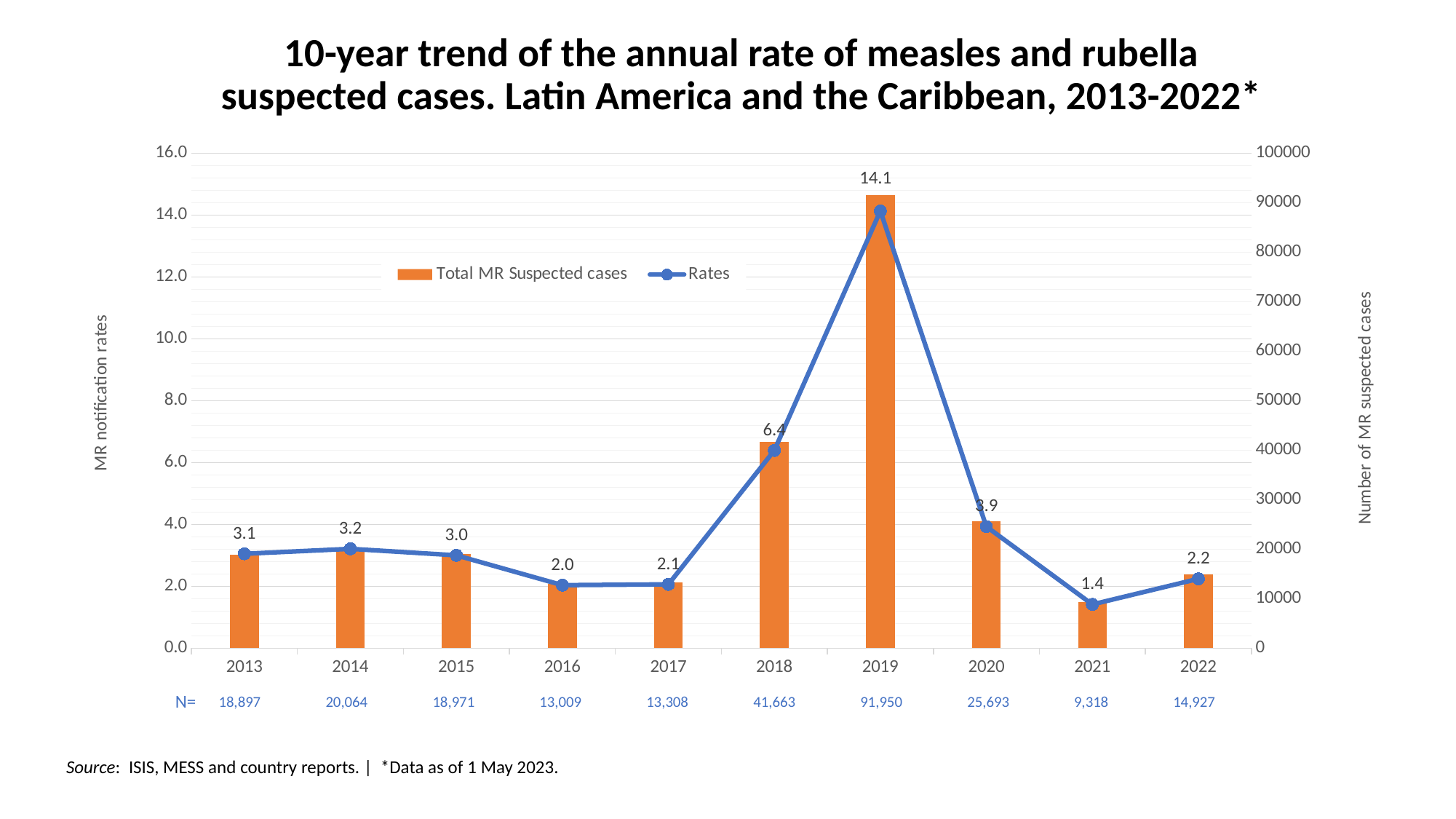
What is the number of MR suspected cases (N=) shown for 2018? 41,663 Which year has the lowest MR notification rate? 2021 What is the MR notification rate for 2019? 14.1 Does the MR notification rate rise or fall from 2019 to 2021? fall Is the number of MR suspected cases for 2019 greater or less than 80000? greater What is the difference between the MR notification rates for 2019 and 2018? 7.7 Which year has the larger number of MR suspected cases, 2020 or 2022? 2020 Which series is shown as orange bars? Total MR Suspected cases What is the MR notification rate for 2016? 2.0 How many series does the legend list? 2 How many years are shown on the x axis? 10 Which year has the highest MR notification rate? 2019